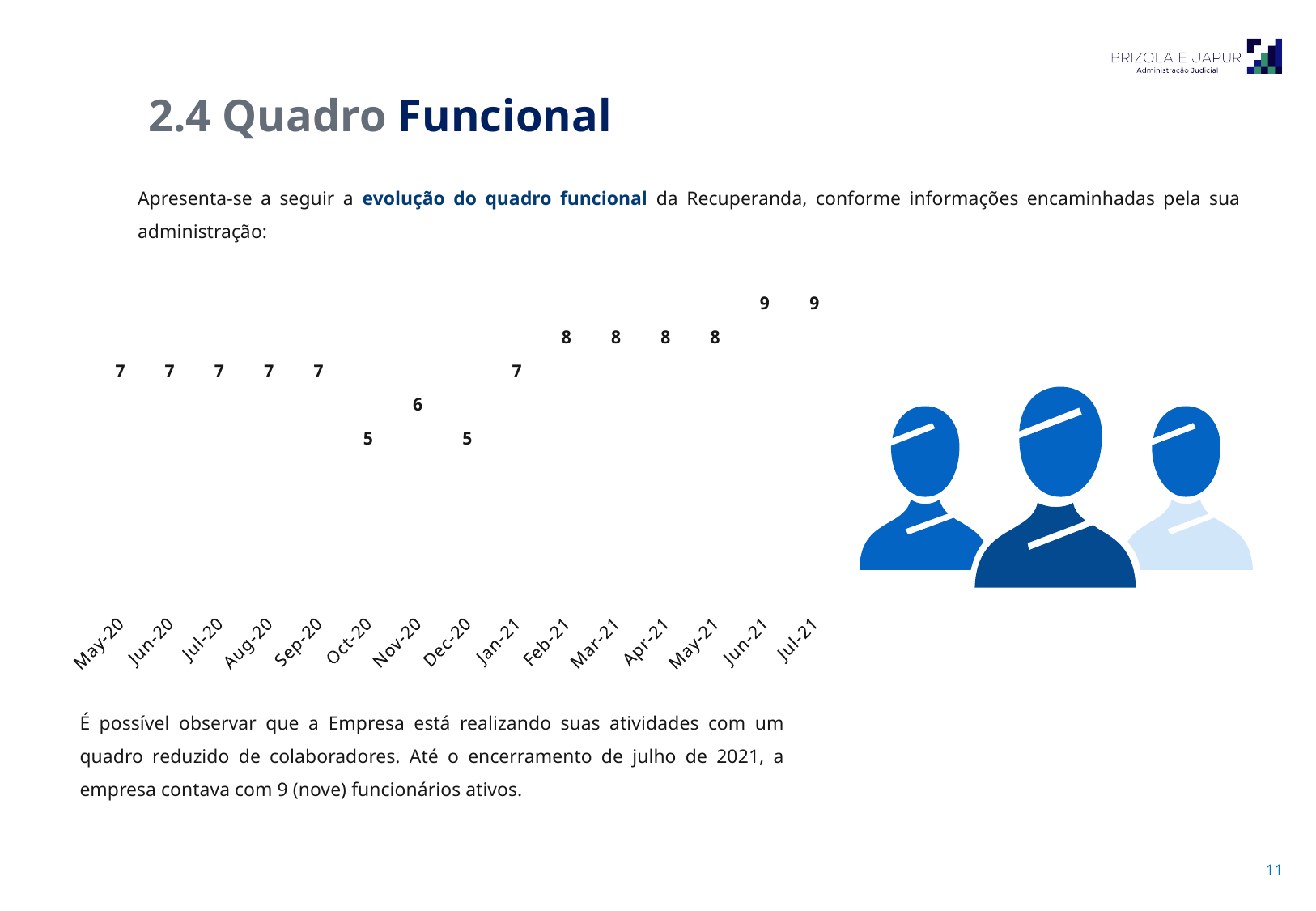
What is the value for Nov-20? 6 What is the value for Feb-21? 8 What is the difference between the values for Feb-21 and Jan-21? 1 What is the difference between the values for Jul-21 and Dec-20? 4 Do the values rise or fall from Jan-21 to Jul-21? rise Which is larger, the value for Nov-20 or the value for Dec-20? Nov-20 What is the highest value shown in the chart? 9 What is the value for Oct-20? 5 What is the value for Jul-21? 9 What is the lowest value shown in the chart? 5 What is the value for May-20? 7 How many months are shown on the x axis of the chart? 15